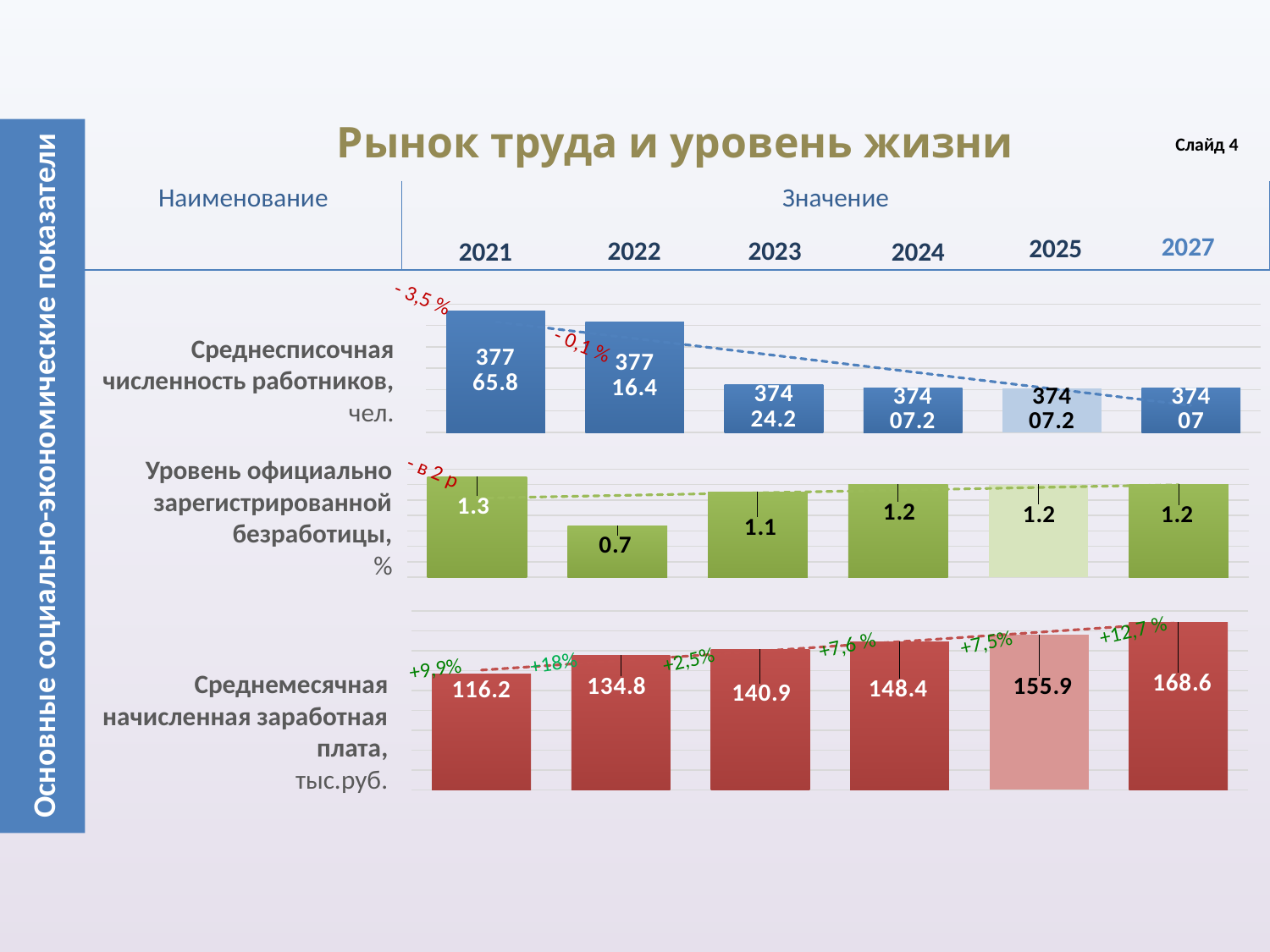
In the chart 'Уровень официально зарегистрированной безработицы, %', which year has the highest value? 2021 In the chart 'Среднесписочная численность работников, чел.', do the values rise or fall from 2021 to 2027? fall In the chart 'Уровень официально зарегистрированной безработицы, %', which year has the lowest value? 2022 How many bars are shown in the chart 'Среднемесячная начисленная заработная плата, тыс.руб.'? 6 In the chart 'Среднемесячная начисленная заработная плата, тыс.руб.', what is the value for 2027? 168.6 In the chart 'Среднемесячная начисленная заработная плата, тыс.руб.', what is the value for 2021? 116.2 In the chart 'Среднемесячная начисленная заработная плата, тыс.руб.', which is larger, the value for 2023 or for 2024? 2024 In the chart 'Уровень официально зарегистрированной безработицы, %', what is the value for 2022? 0.7 In the chart 'Среднемесячная начисленная заработная плата, тыс.руб.', what is the difference between the 2027 and 2021 values? 52.4 In the chart 'Среднемесячная начисленная заработная плата, тыс.руб.', what is the difference between the 2022 and 2021 values? 18.6 What kind of chart is used for 'Среднесписочная численность работников, чел.'? bar chart In the chart 'Среднемесячная начисленная заработная плата, тыс.руб.', do the values rise or fall from 2021 to 2027? rise